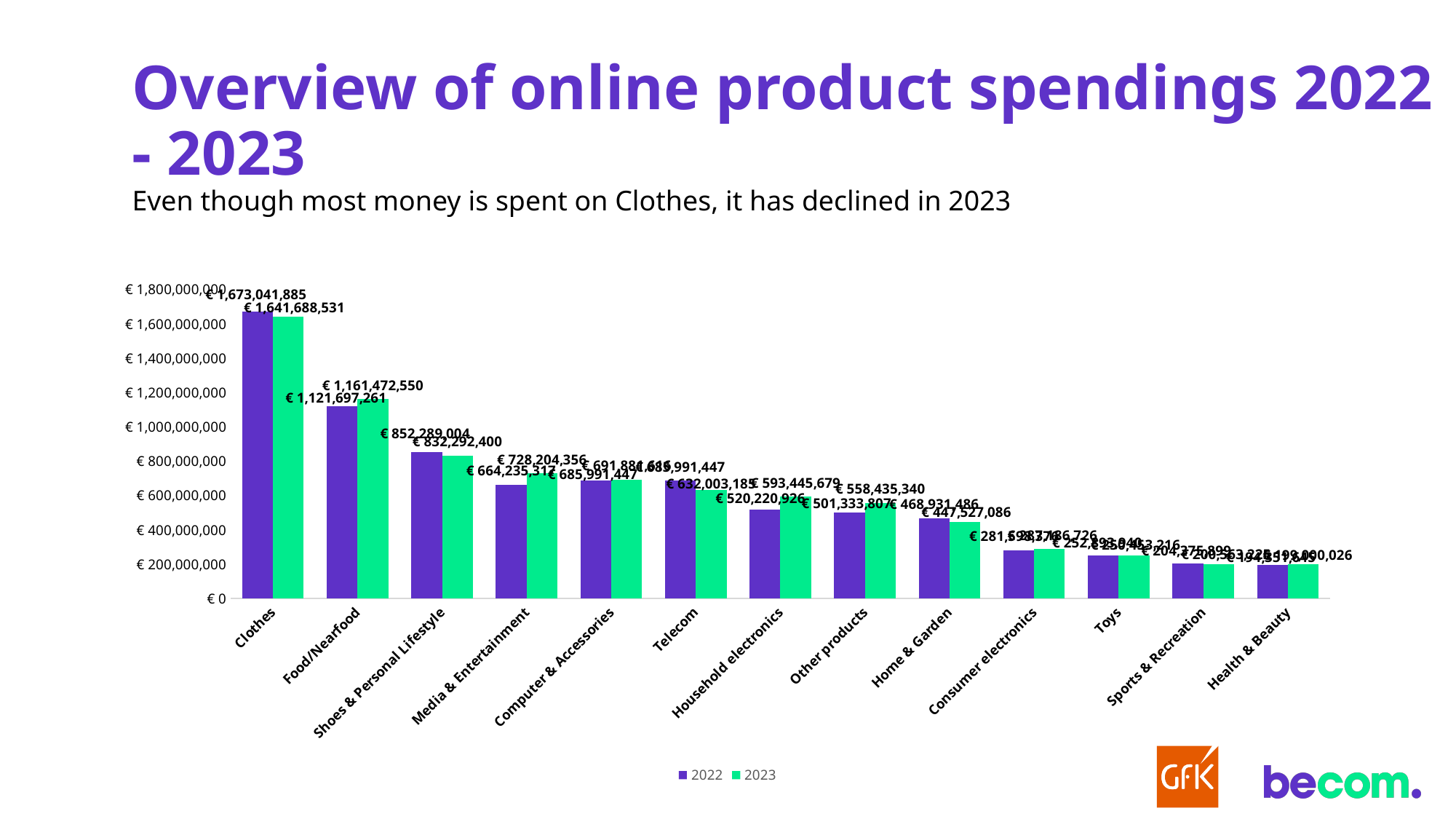
How many product categories are shown on the x axis? 13 What was the online spending on Clothes in 2023? € 1,641,688,531 What was the online spending on Household electronics in 2023? € 593,445,679 Which category has the highest online spending in 2023? Clothes For Food/Nearfood, which year had the higher online spending, 2022 or 2023? 2023 What was the online spending on Food/Nearfood in 2023? € 1,161,472,550 What was the online spending on Clothes in 2022? € 1,673,041,885 What was the online spending on Shoes & Personal Lifestyle in 2022? € 852,289,004 By how much did online spending on Clothes decrease from 2022 to 2023? € 31,353,354 What kind of chart is shown on the slide? bar chart How many series does the legend list? 2 Is the 2023 value for Toys greater or less than € 400,000,000? less